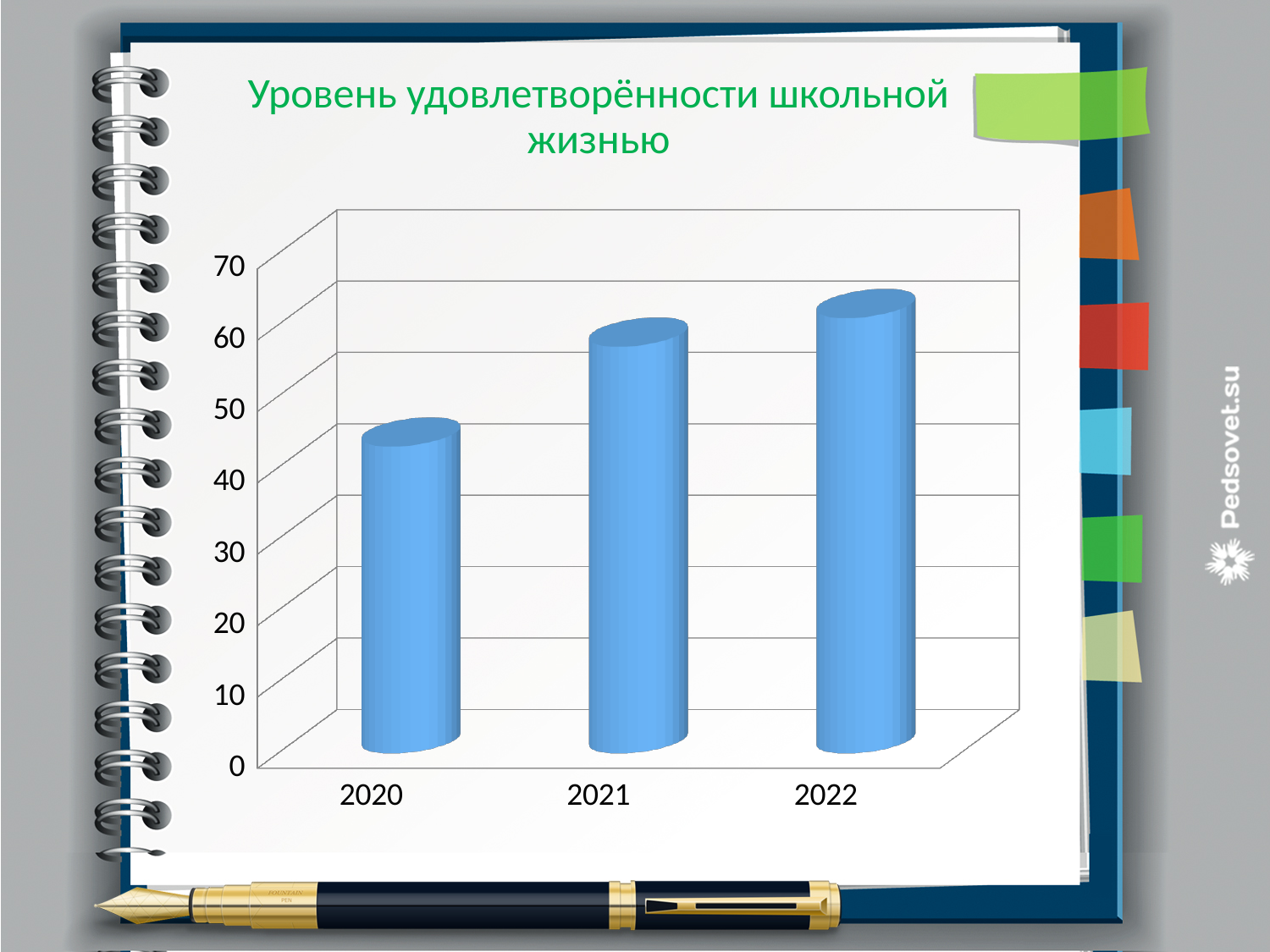
Is the value for 2021 greater or less than 50? greater Which year has the lowest level of satisfaction with school life? 2020 What kind of chart is shown on the slide? bar chart Which year has the highest level of satisfaction with school life? 2022 Is the value for 2020 greater or less than 50? less Which is larger, the value for 2020 or the value for 2021? 2021 What is the title of the chart? Уровень удовлетворённости школьной жизнью What is the highest value shown on the vertical axis of the chart? 70 Is the value for 2022 greater or less than 50? greater How many years are shown on the x axis of the chart? 3 Do the values rise or fall from 2020 to 2022? rise